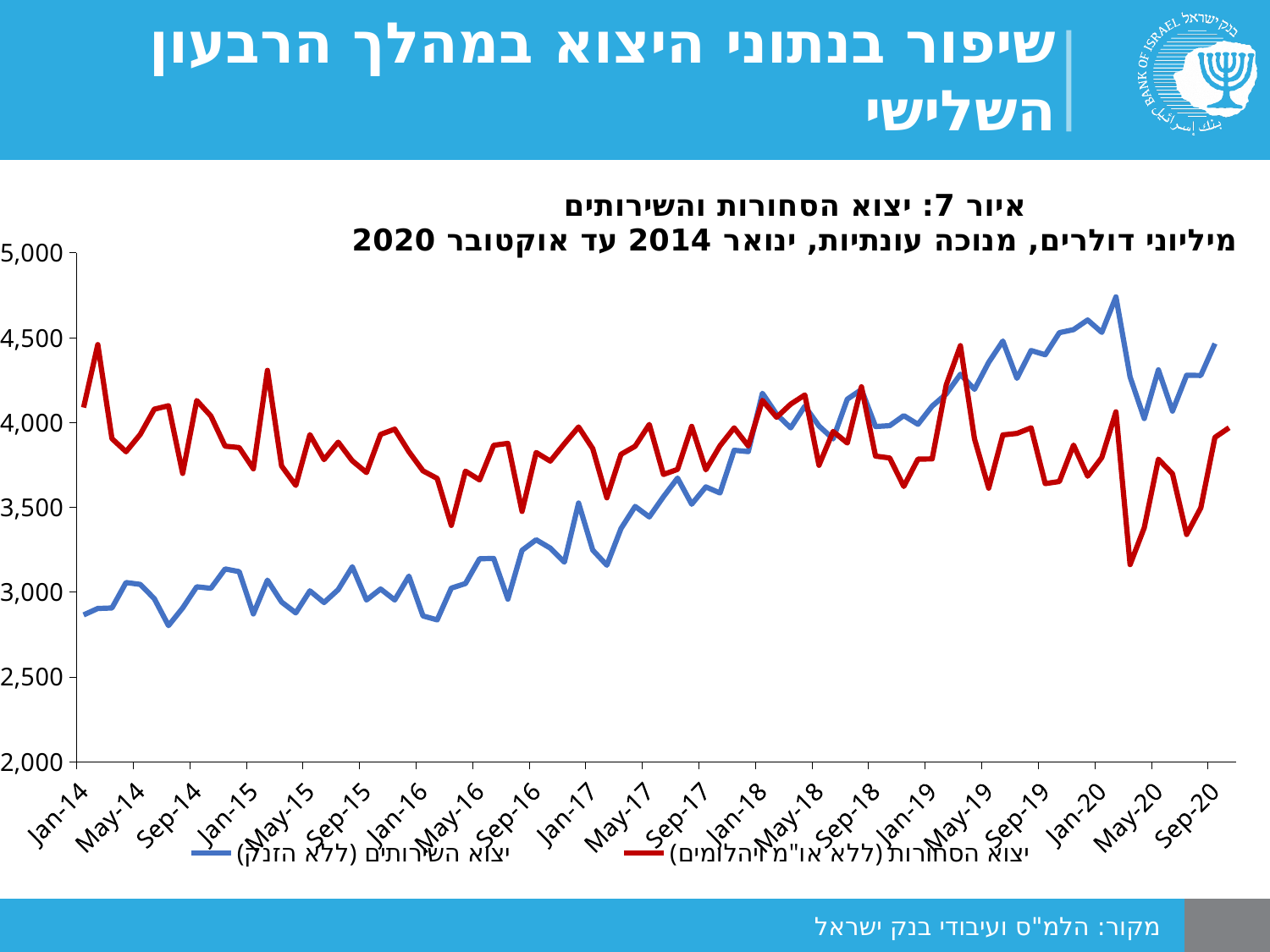
At Sep-20, which series has the higher value: יצוא השירותים (ללא הזנק) or יצוא הסחורות (ללא או"מ ויהלומים)? יצוא השירותים (ללא הזנק) Is the value of יצוא הסחורות (ללא או"מ ויהלומים) at Jan-14 greater or less than 4,000? greater Is the value of יצוא הסחורות (ללא או"מ ויהלומים) at Jan-16 greater or less than 4,000? less Is the value of יצוא השירותים (ללא הזנק) at Jan-14 greater or less than 3,000? less At Jan-14, which series has the higher value: יצוא השירותים (ללא הזנק) or יצוא הסחורות (ללא או"מ ויהלומים)? יצוא הסחורות (ללא או"מ ויהלומים) What colour is the line for יצוא השירותים (ללא הזנק)? blue How many series does the legend list? 2 Does the יצוא השירותים (ללא הזנק) series generally rise or fall from Jan-14 to Jan-20? rise What is the figure number given in the chart title? איור 7 What kind of chart is shown on the slide? line chart